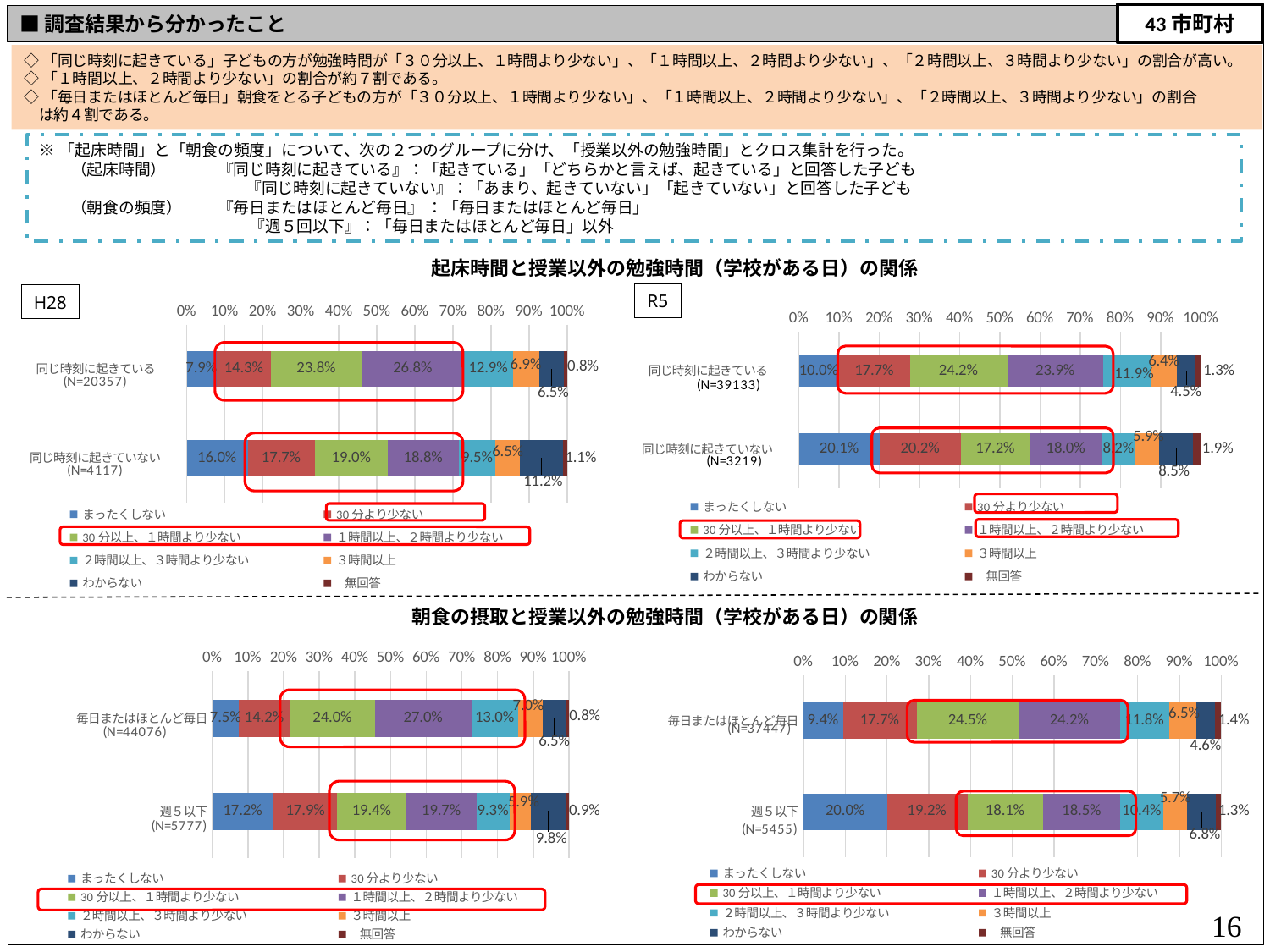
In the bottom-left chart (H28, 朝食の摂取と授業以外の勉強時間), which is larger for 週5以下: 「30分以上、1時間より少ない」 or 「1時間以上、2時間より少ない」? 1時間以上、2時間より少ない In the top-left chart (H28, 起床時間と授業以外の勉強時間), what is the value of 「まったくしない」 for 同じ時刻に起きていない? 16.0% How many categories (bars) are shown in the top-right chart (R5, 起床時間と授業以外の勉強時間)? 2 In the top-right chart (R5, 起床時間と授業以外の勉強時間), what is the difference between the 「まったくしない」 values for 同じ時刻に起きていない and 同じ時刻に起きている? 10.1% In the bottom-right chart (R5, 朝食の摂取と授業以外の勉強時間), which segment is the largest for 毎日またはほとんど毎日? 30分以上、1時間より少ない In the bottom-right chart (R5, 朝食の摂取と授業以外の勉強時間), what is the difference between the 「わからない」 values for 週5以下 and 毎日またはほとんど毎日? 2.2% In the bottom-left chart (H28, 朝食の摂取と授業以外の勉強時間), what is the value of 「1時間以上、2時間より少ない」 for 毎日またはほとんど毎日? 27.0% In the top-right chart (R5, 起床時間と授業以外の勉強時間), what is the value of 「30分以上、1時間より少ない」 for 同じ時刻に起きている? 24.2% In the bottom-right chart (R5, 朝食の摂取と授業以外の勉強時間), what is the value of 「まったくしない」 for 週5以下? 20.0% What kind of chart is the bottom-left chart (H28, 朝食の摂取と授業以外の勉強時間)? Stacked bar chart How many series does the legend of the top-left chart (H28, 起床時間と授業以外の勉強時間) list? 8 In the top-left chart (H28, 起床時間と授業以外の勉強時間), what is the value of 「1時間以上、2時間より少ない」 for 同じ時刻に起きている? 26.8%